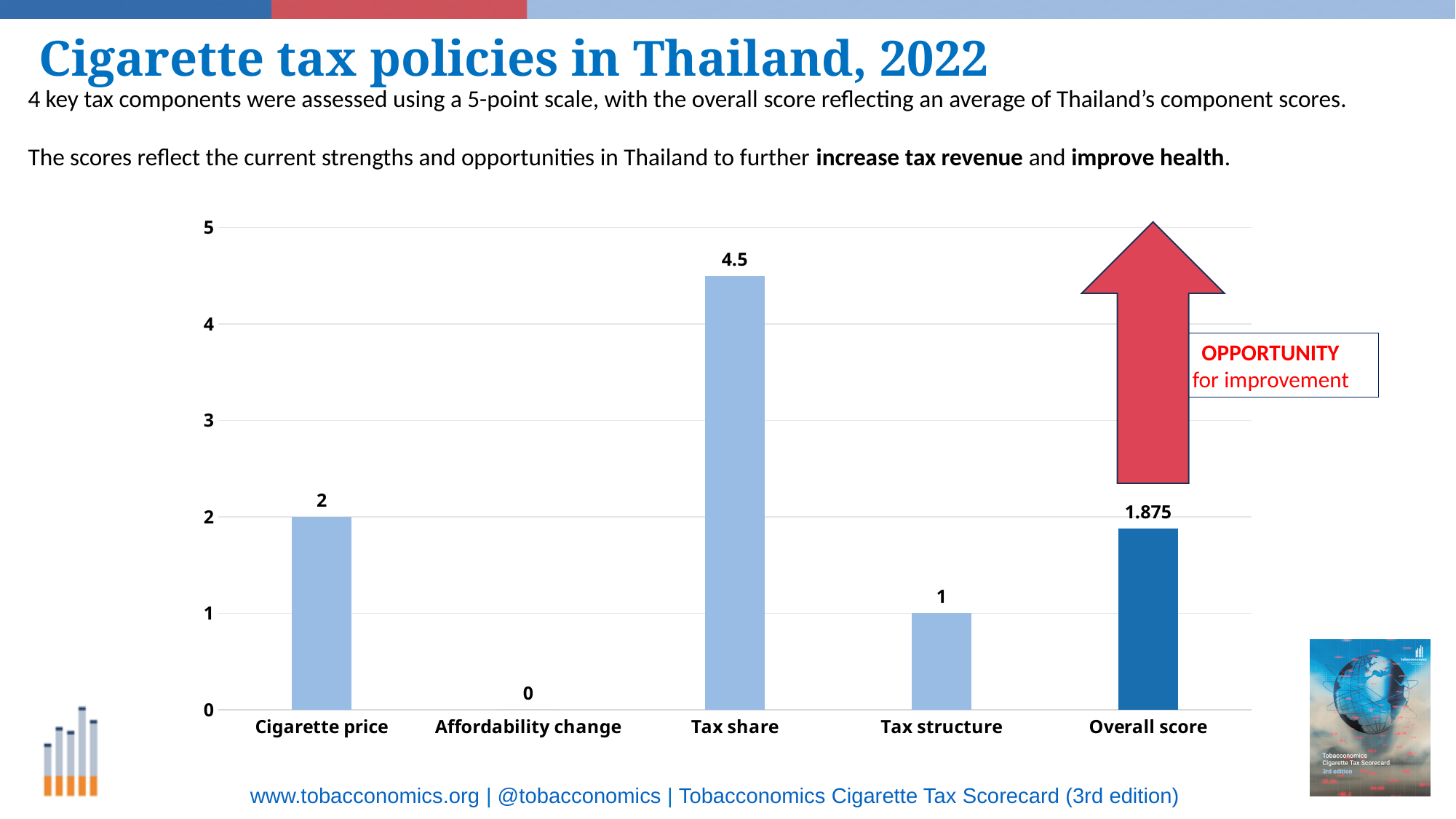
What is the maximum value shown on the y axis? 5 Which is larger, the value for Cigarette price or the value for Overall score? Cigarette price What is the value for Overall score? 1.875 What is the value for Tax share? 4.5 Which category has the lowest value? Affordability change What is the difference between the values for Tax share and Tax structure? 3.5 What is the value for Cigarette price? 2 Which category has the highest value? Tax share What kind of chart is shown on the slide? Bar chart How many categories are shown on the x axis? 5 Is the value for Tax share greater or less than 4? greater What is the value for Affordability change? 0